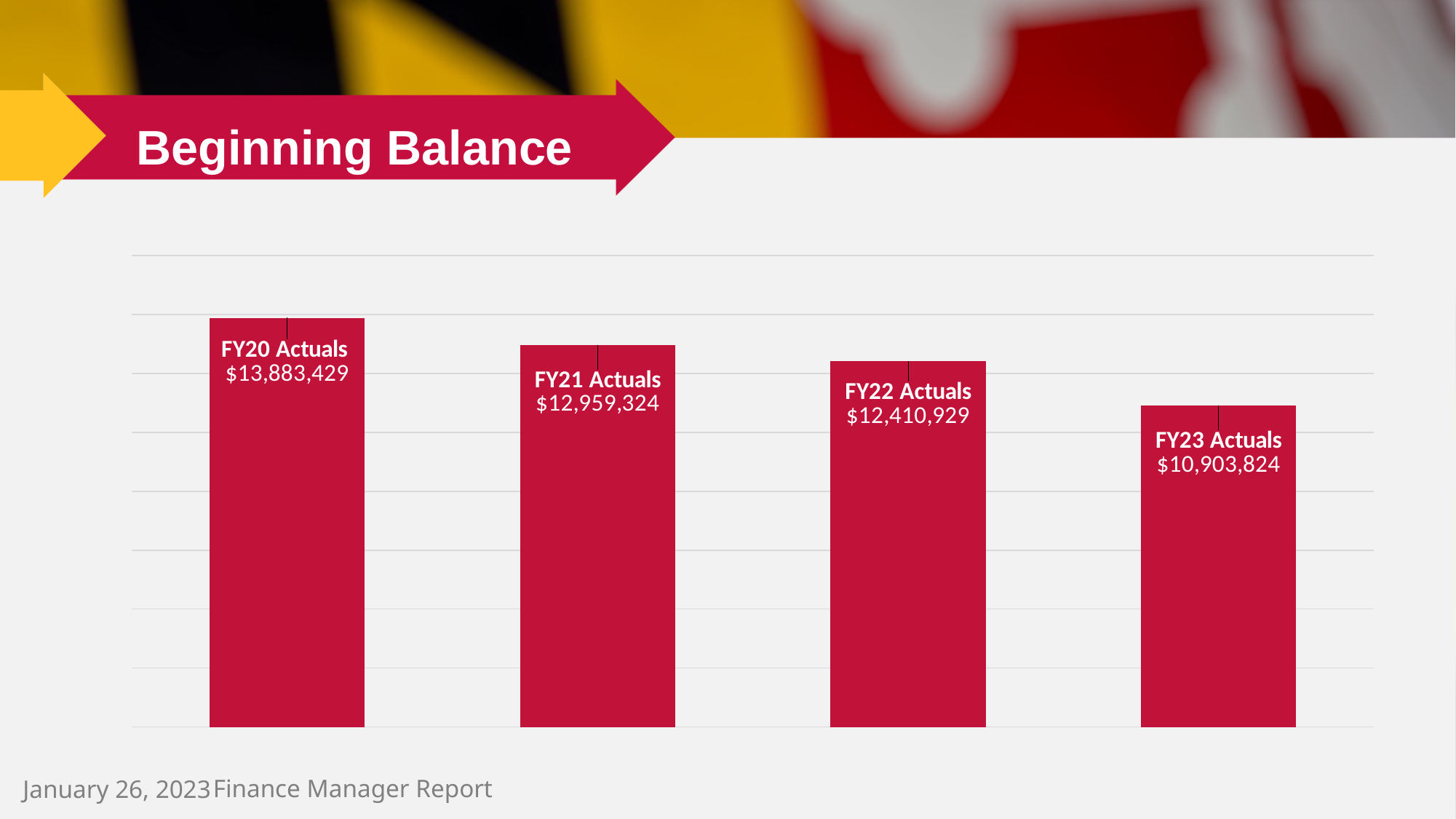
What is the value for FY20 Actuals? $13,883,429 What is the value for FY22 Actuals? $12,410,929 What is the difference between FY20 Actuals and FY21 Actuals? $924,105 Which category has the lowest value? FY23 Actuals What is the value for FY23 Actuals? $10,903,824 How many bars are shown in the chart? 4 What is the difference between FY22 Actuals and FY23 Actuals? $1,507,105 Which category has the highest value? FY20 Actuals Which is larger, FY21 Actuals or FY22 Actuals? FY21 Actuals What is the value for FY21 Actuals? $12,959,324 Do the values rise or fall from FY20 Actuals to FY23 Actuals? Fall What kind of chart is shown on the slide? Bar chart